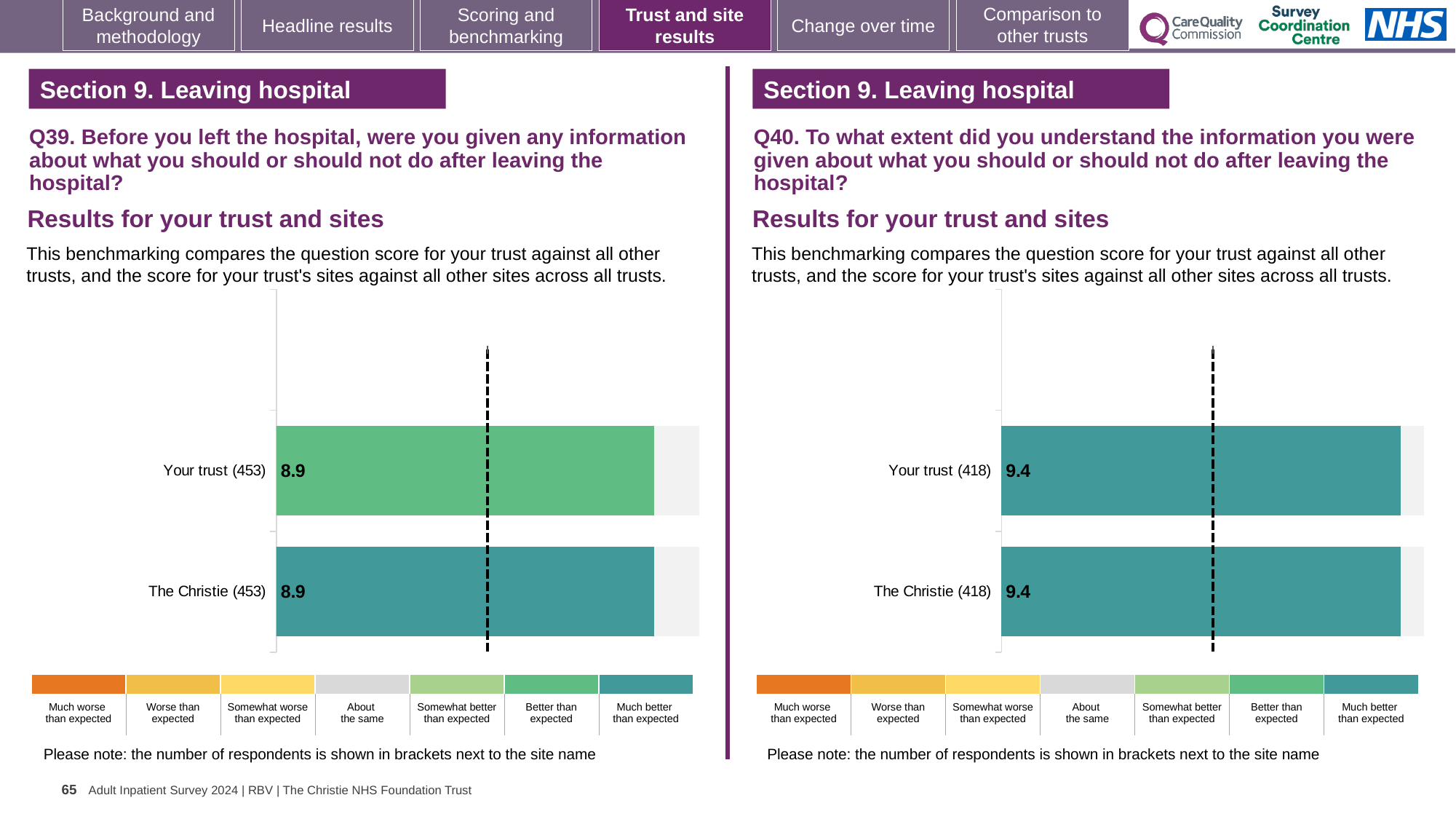
On the Q39 chart (left), how many bars are plotted? 2 On the Q40 chart (right), how many respondents are shown in brackets for The Christie? 418 On the Q39 chart (left), what is the difference between the scores for Your trust and The Christie? 0 Is the score for Your trust on the Q40 chart (right) larger or smaller than the score for Your trust on the Q39 chart (left)? Larger What type of chart is used on the Q39 chart (left)? Bar chart On the Q39 chart (left), how many respondents are shown in brackets for Your trust? 453 On the Q40 chart (right), what is the difference between the scores for Your trust and The Christie? 0 On the Q39 chart (left), what is the score for The Christie? 8.9 On the Q40 chart (right), how many bars are plotted? 2 On the Q40 chart (right), what is the score for Your trust? 9.4 On the Q40 chart (right), what is the score for The Christie? 9.4 On the Q39 chart (left), what is the score for Your trust? 8.9